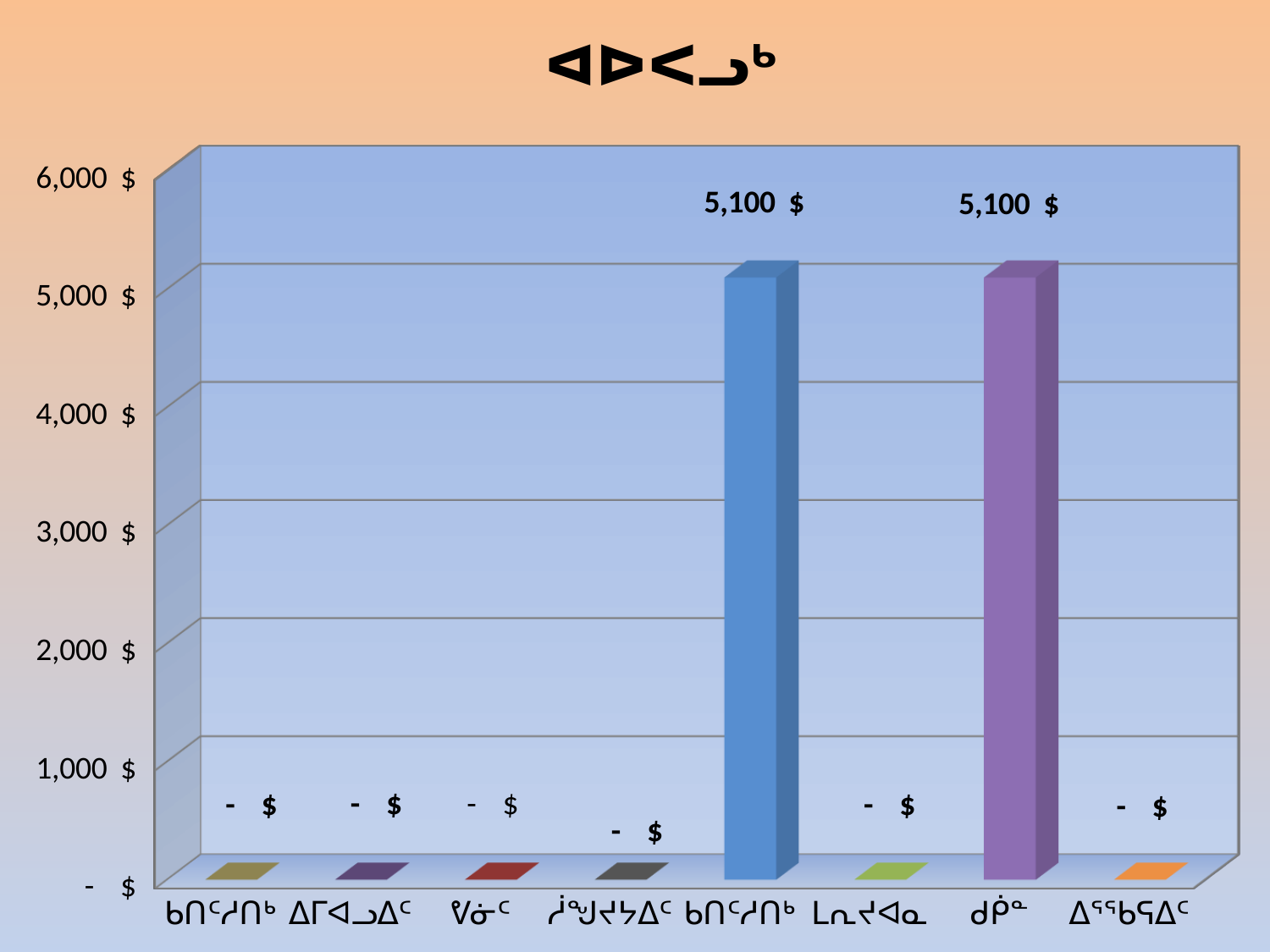
Is the value for the fifth bar from the left greater or less than 5,000 $? greater How many categories are plotted along the x axis? 8 What is the value shown for the fifth bar from the left (the blue bar)? 5,100 $ Is the value of the blue bar larger than, smaller than, or equal to the value of the purple bar? equal What is the value shown for the seventh bar from the left (the purple bar)? 5,100 $ What value label is shown above the first bar from the left? - $ How many bars have a value of 5,100 $? 2 Is the value for the seventh bar from the left greater or less than 6,000 $? less What is the difference between the values of the blue bar and the purple bar? 0 $ What is the highest tick value shown on the vertical axis? 6,000 $ What is the title of the chart? ᐊᐅᐸᓗᒃ What kind of chart is shown on the slide? bar chart